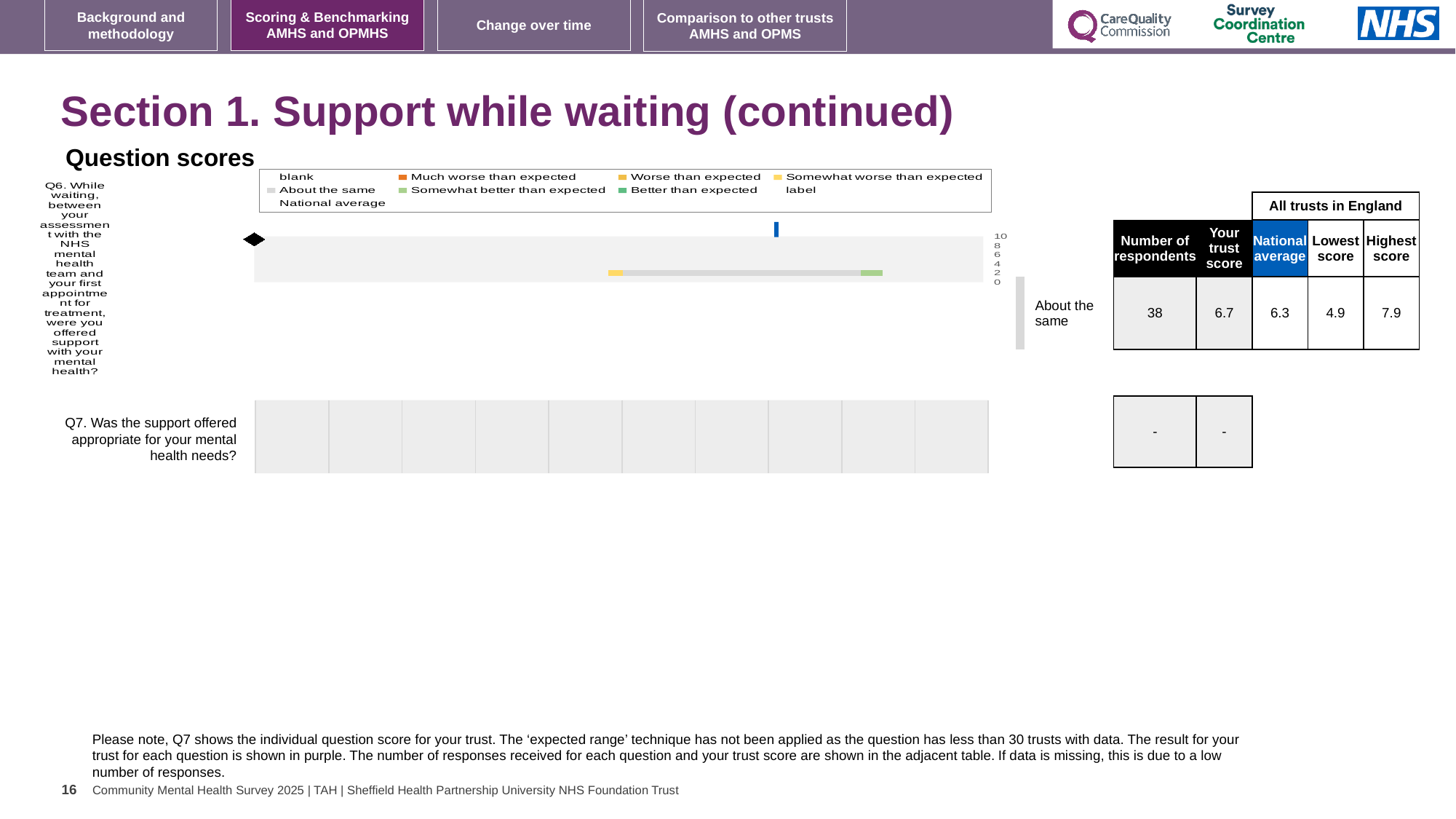
What is the highest score among all trusts in England for Q6? 7.9 What is the difference between the trust score and the national average for Q6? 0.4 What is the lowest score among all trusts in England for Q6? 4.9 How many respondents answered Q6? 38 What is the national average for Q6 shown in the table beside the chart? 6.3 Which expected-range category is Q6 labelled with next to the chart? About the same What is the trust score for Q6 shown in the table beside the chart? 6.7 What value is shown for the number of respondents and trust score for Q7? - What is the highest value shown on the chart's score axis? 10 For Q6, which is larger: the trust score or the national average? trust score What kind of chart is used to show the Q6 question score? bar chart